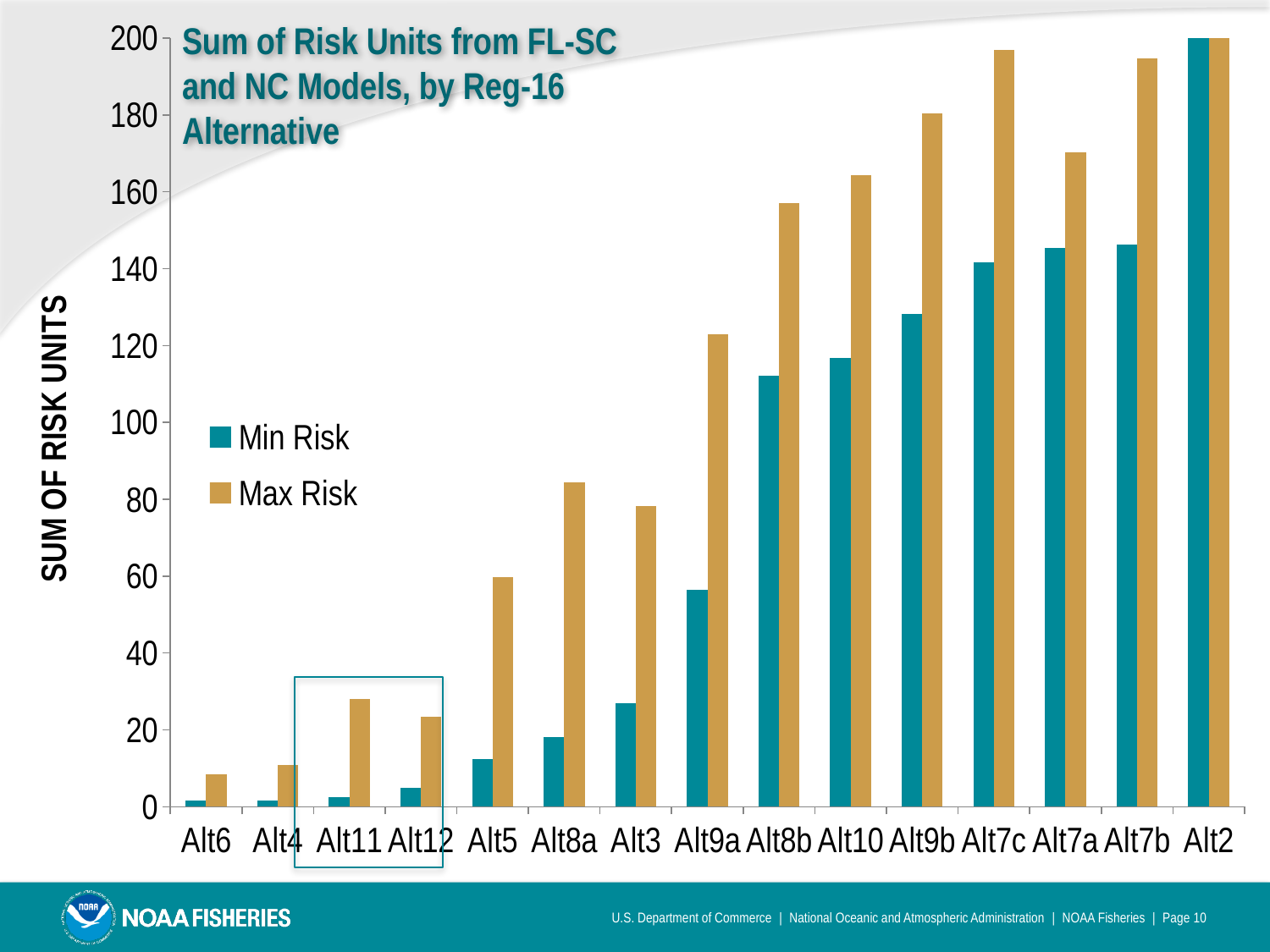
Is the Max Risk value for Alt7c greater or less than 180? greater What kind of chart is shown on the slide? bar chart Which is larger, the Min Risk value for Alt9b or the Min Risk value for Alt7c? Alt7c How many series does the legend list? 2 How many alternatives (categories) are shown on the x axis? 15 Is the Max Risk value for Alt5 greater or less than 80? less Do the Max Risk values generally rise or fall moving from left to right along the x axis? rise Which alternative has the highest Max Risk value? Alt2 What is the label on the y axis of the chart? SUM OF RISK UNITS Is the Min Risk value for Alt9a greater or less than 40? greater Which alternative has the highest Min Risk value? Alt2